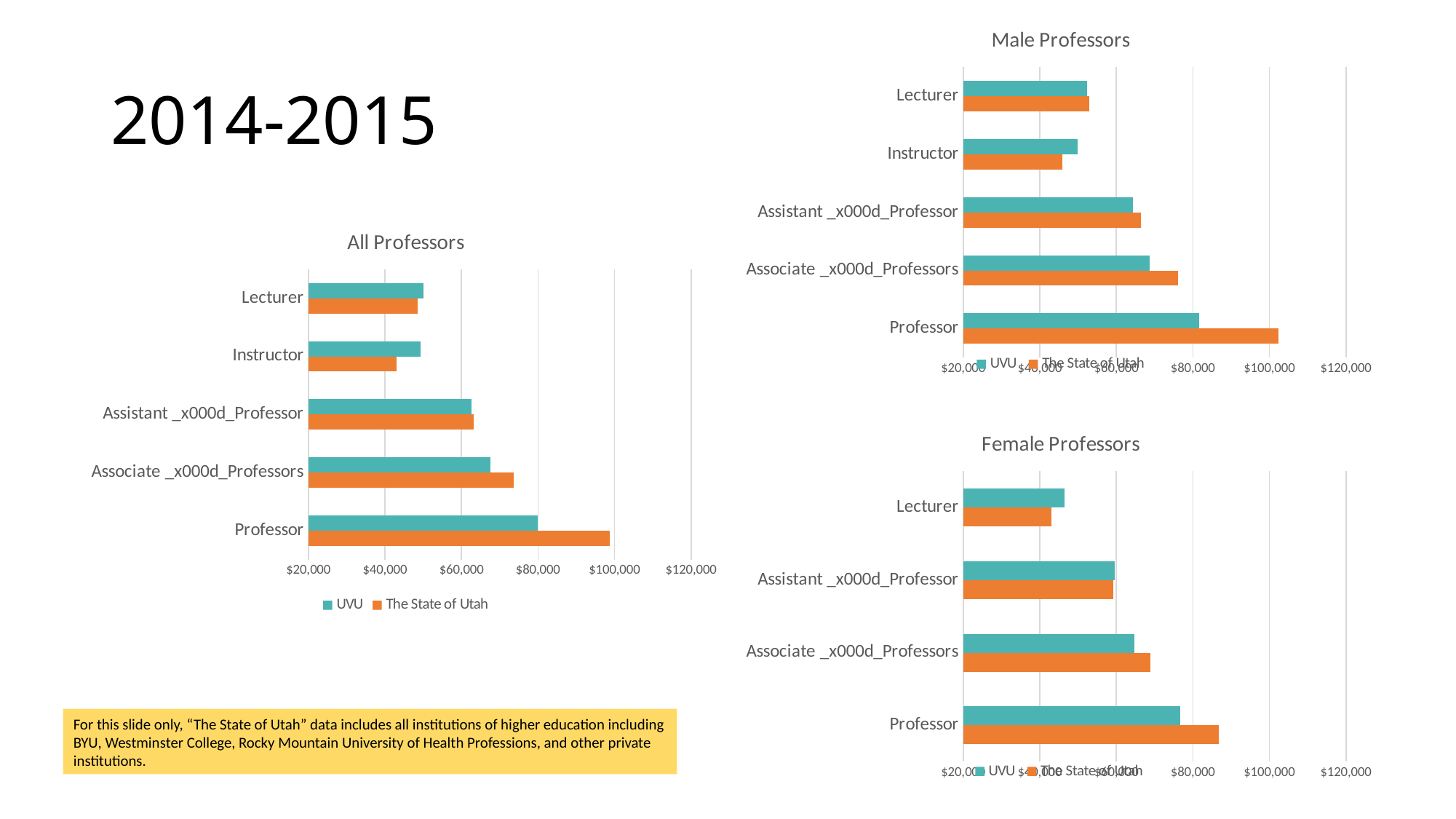
In the "All Professors" chart, which category has the lowest value for The State of Utah? Instructor How many categories are shown on the "Female Professors" chart? 4 In the "Male Professors" chart, is the value for Associate Professors for The State of Utah greater or less than $60,000? greater In the "Male Professors" chart, for Instructor, which is larger: UVU or The State of Utah? UVU What kind of chart is the "All Professors" chart? bar chart In the "All Professors" chart, which category has the highest value for The State of Utah? Professor Which colour represents The State of Utah in the charts? orange How many categories are shown on the "Male Professors" chart? 5 In the "All Professors" chart, for Professor, which is larger: UVU or The State of Utah? The State of Utah In the "Female Professors" chart, is the value for Professor for The State of Utah greater or less than $80,000? greater In the "All Professors" chart, is the value for Lecturer for UVU greater or less than $60,000? less How many series does the legend of the "All Professors" chart list? 2